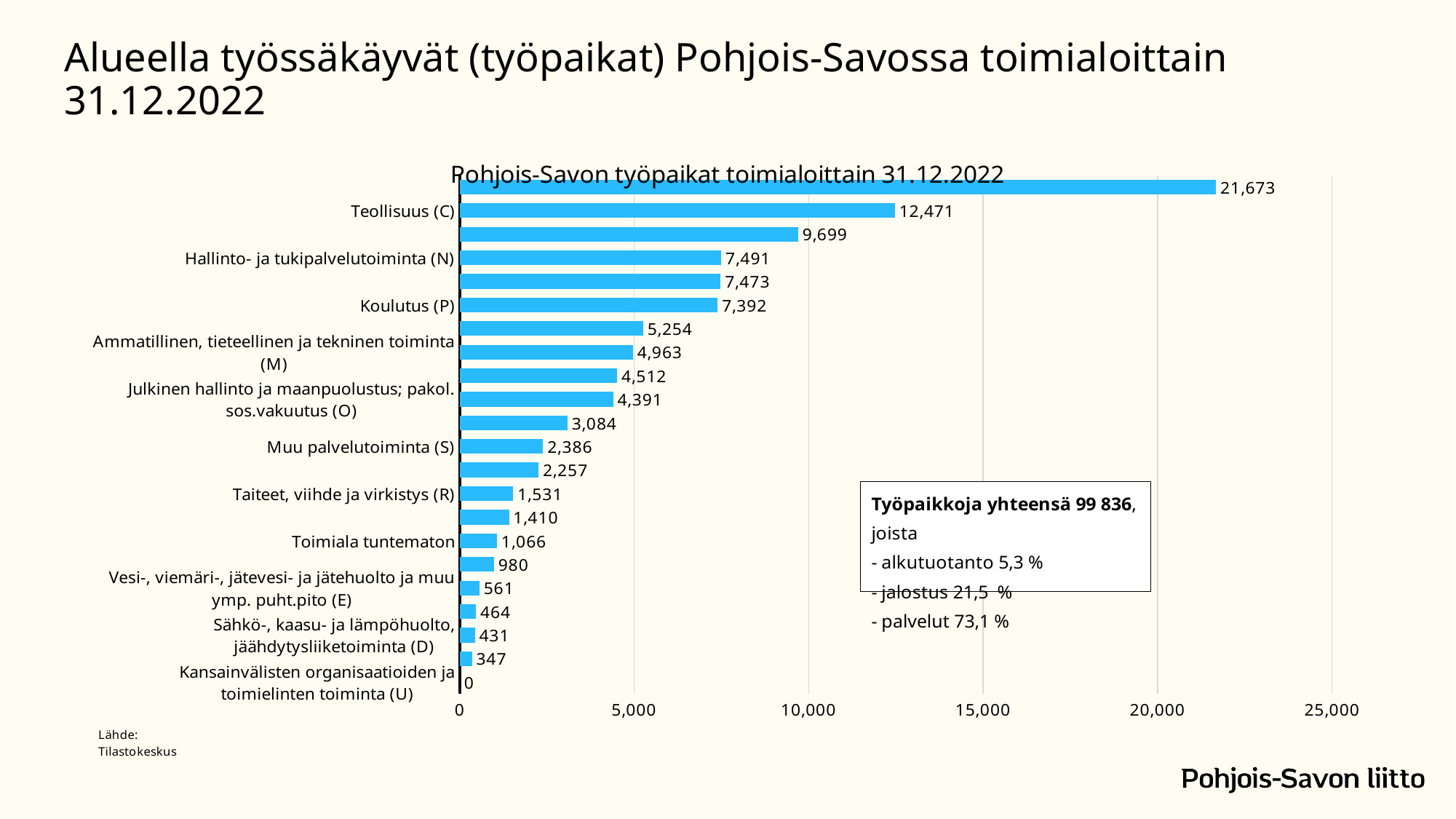
What is the title of the chart? Pohjois-Savon työpaikat toimialoittain 31.12.2022 What is the value for Teollisuus (C)? 12,471 What is the value for Hallinto- ja tukipalvelutoiminta (N)? 7,491 What is the difference between the values for Teollisuus (C) and Koulutus (P)? 5,079 How many bars are plotted on the chart? 22 What is the value for Toimiala tuntematon? 1,066 What is the value for Muu palvelutoiminta (S)? 2,386 Which category has the lowest value? Kansainvälisten organisaatioiden ja toimielinten toiminta (U) What is the value for Koulutus (P)? 7,392 What is the highest value shown on the chart? 21,673 What kind of chart is shown on the slide? Bar chart Which is larger, the value for Hallinto- ja tukipalvelutoiminta (N) or the value for Koulutus (P)? Hallinto- ja tukipalvelutoiminta (N)